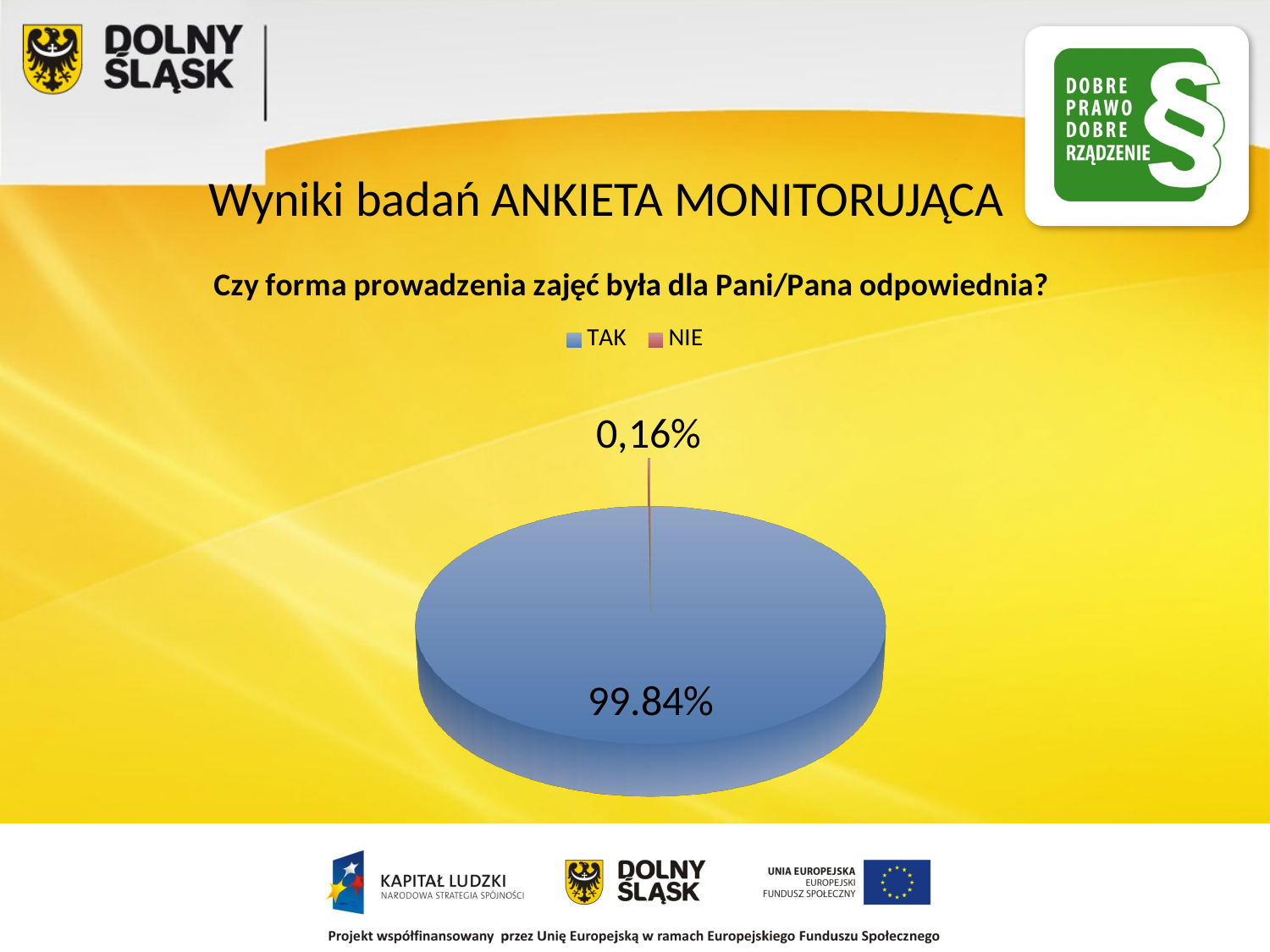
How many categories does the legend list? 2 Which answer has a larger share, TAK or NIE? TAK How many slices does the pie chart have? 2 What percentage of respondents answered NIE? 0,16% What question does the chart title ask? Czy forma prowadzenia zajęć była dla Pani/Pana odpowiednia? What kind of chart is shown on the slide? pie chart What colour represents TAK in the chart? blue What percentage of respondents answered TAK? 99.84% Which answer has the largest share of the pie? TAK Which answer has the smallest share of the pie? NIE Is the share for TAK greater or less than 50%? greater